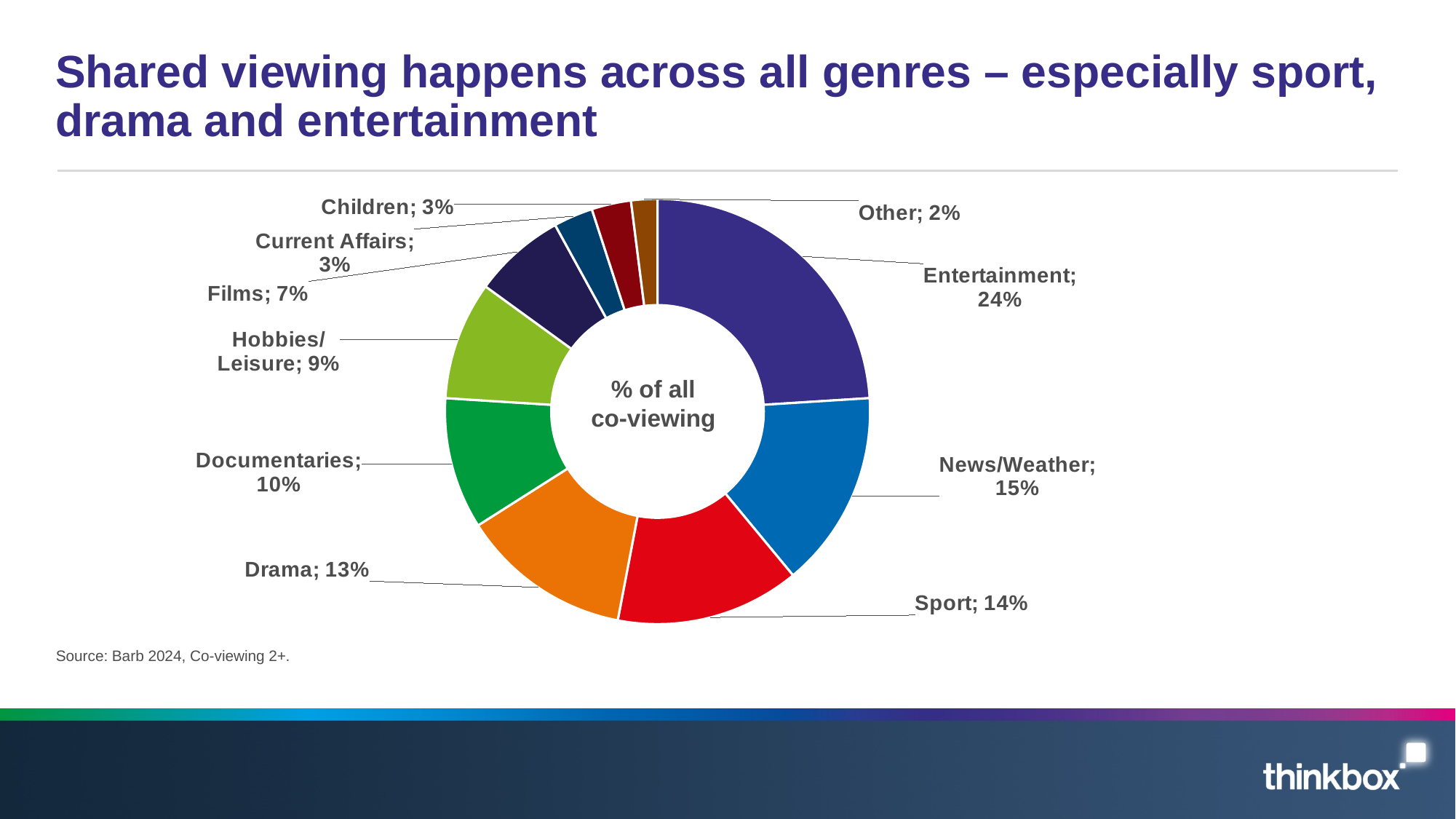
What kind of chart is shown on the slide? Pie chart (doughnut) What is the difference in percentage points between Entertainment and Drama? 11 Which genre has the largest share of co-viewing? Entertainment How many genre categories are shown in the chart? 10 What share of all co-viewing is Entertainment? 24% What text is shown in the centre of the chart? % of all co-viewing What share of all co-viewing is Hobbies/Leisure? 9% What share of all co-viewing is Documentaries? 10% What share of all co-viewing is News/Weather? 15% What share of all co-viewing is Sport? 14% Which genre has the smallest share of co-viewing? Other Which has a larger share of co-viewing, Films or Documentaries? Documentaries